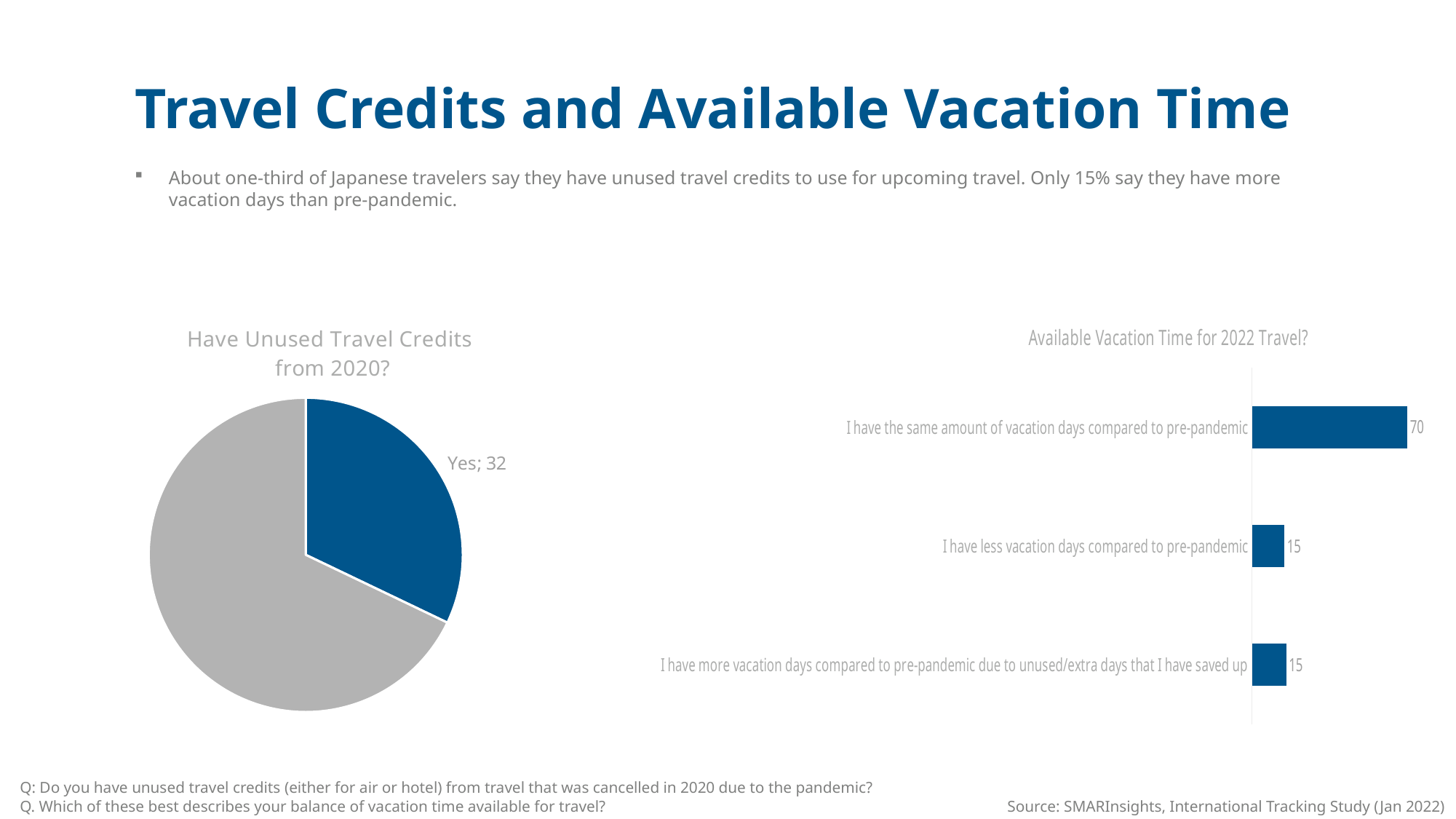
In the pie chart 'Have Unused Travel Credits from 2020?', which slice is larger: the blue 'Yes' slice or the gray slice? the gray slice In the chart 'Available Vacation Time for 2022 Travel?', which is larger: the value for 'I have the same amount of vacation days compared to pre-pandemic' or the value for 'I have more vacation days compared to pre-pandemic due to unused/extra days that I have saved up'? I have the same amount of vacation days compared to pre-pandemic How many categories are shown in the chart 'Available Vacation Time for 2022 Travel?'? 3 What kind of chart is 'Available Vacation Time for 2022 Travel?'? bar chart In the chart 'Available Vacation Time for 2022 Travel?', what is the value for 'I have the same amount of vacation days compared to pre-pandemic'? 70 In the chart 'Available Vacation Time for 2022 Travel?', what is the value for 'I have more vacation days compared to pre-pandemic due to unused/extra days that I have saved up'? 15 What is the title of the pie chart on the left of the slide? Have Unused Travel Credits from 2020? In the pie chart 'Have Unused Travel Credits from 2020?', what value is shown for the 'Yes' slice? 32 In the chart 'Available Vacation Time for 2022 Travel?', which category has the highest value? I have the same amount of vacation days compared to pre-pandemic In the chart 'Available Vacation Time for 2022 Travel?', what is the difference between the value for 'I have the same amount of vacation days compared to pre-pandemic' and the value for 'I have less vacation days compared to pre-pandemic'? 55 What kind of chart is 'Have Unused Travel Credits from 2020?'? pie chart In the chart 'Available Vacation Time for 2022 Travel?', what is the value for 'I have less vacation days compared to pre-pandemic'? 15